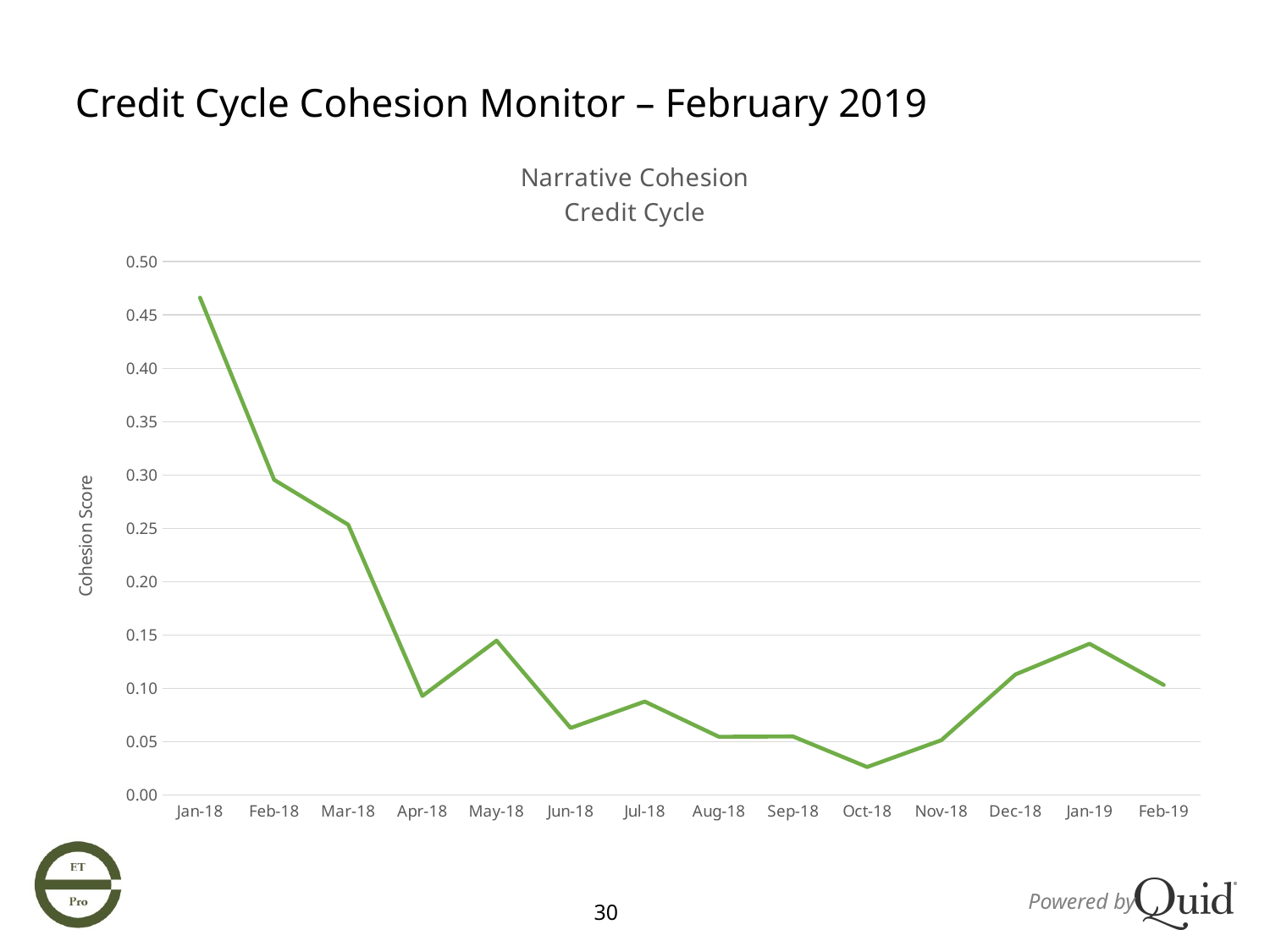
Is the value for Jan-18 greater or less than 0.40? greater Is the value for Oct-18 greater or less than 0.05? less Which month has the lowest cohesion score? Oct-18 Does the cohesion score rise or fall from Jan-18 to Apr-18? Fall Which has the higher cohesion score, Jun-18 or Jan-19? Jan-19 What is the label on the vertical axis? Cohesion Score Which month has the highest cohesion score? Jan-18 What kind of chart is shown on the slide? Line chart Is the value for Apr-18 greater or less than 0.15? less How many months are plotted on the x axis? 14 Which has the higher cohesion score, Mar-18 or Dec-18? Mar-18